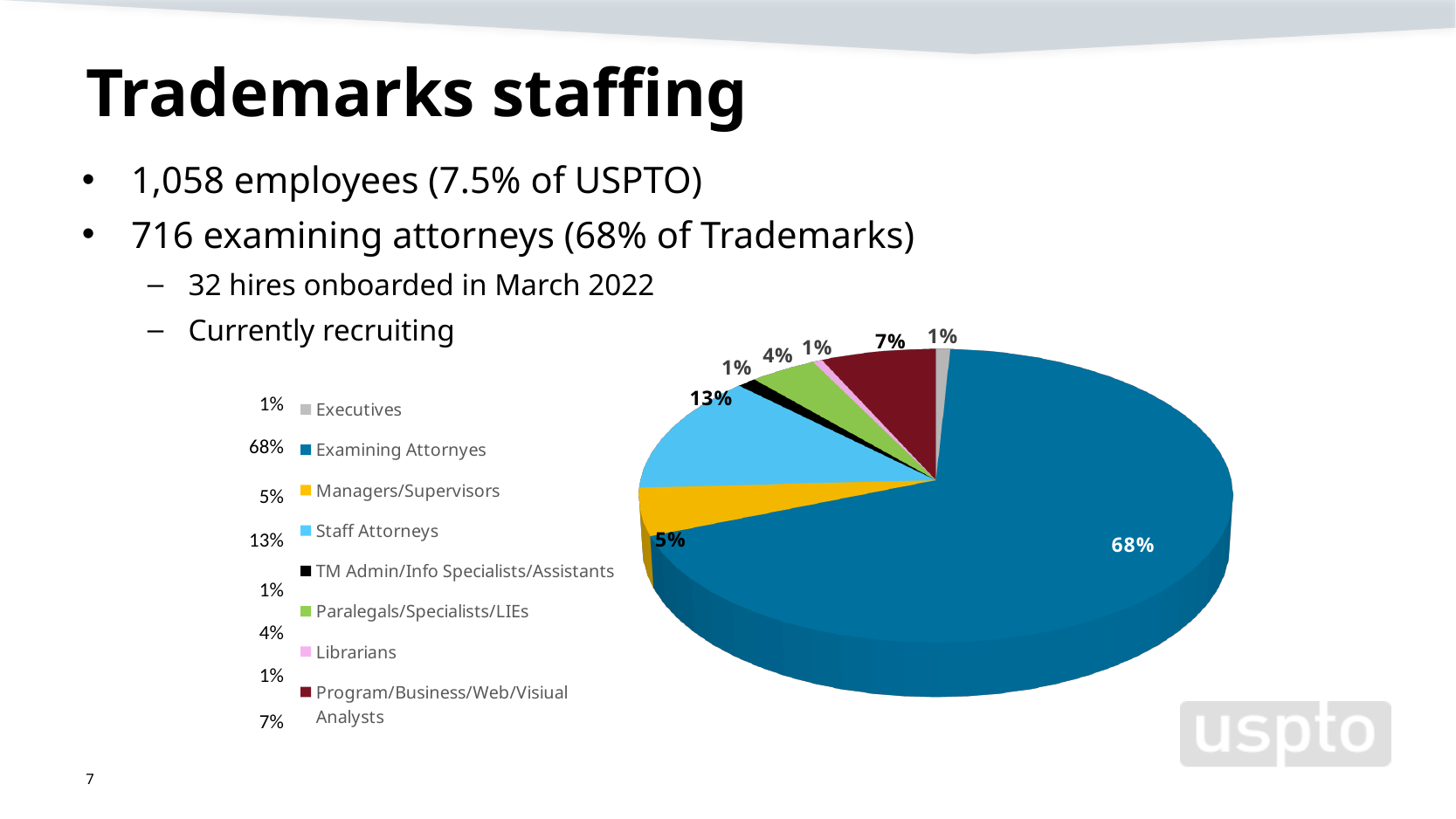
What share of the pie do Managers/Supervisors represent? 5% What share of the pie do Staff Attorneys represent? 13% What is the difference in percentage points between the Examining Attorneys slice and the Staff Attorneys slice? 55 What type of chart is shown on the slide? Pie chart Which category has the largest slice of the pie? Examining Attorneys What share of the pie do Paralegals/Specialists/LIEs represent? 4% How many categories does the pie chart legend list? 8 What colour is the Examining Attorneys slice in the pie chart? Dark blue Which slice is larger: Managers/Supervisors or Program/Business/Web/Visual Analysts? Program/Business/Web/Visual Analysts